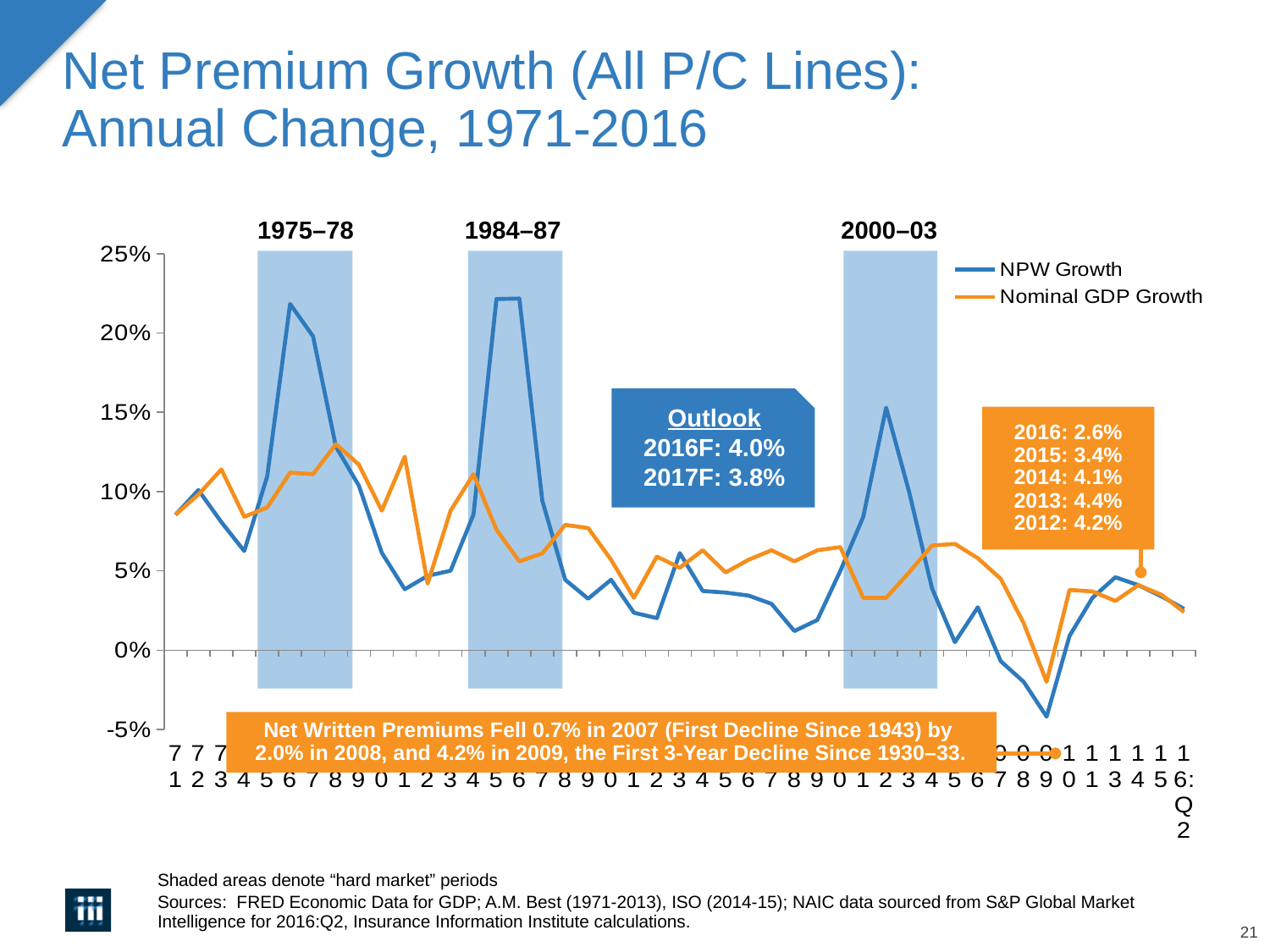
According to the callout, what was net premium growth in 2016? 2.6% What is the difference between the 2013 value (4.4%) and the 2012 value (4.2%) in the callout? 0.2 percentage points By how much did net written premiums fall in 2009, according to the text box? 4.2% What are the two series named in the legend? NPW Growth and Nominal GDP Growth In 2002, which series has the larger value, NPW Growth or Nominal GDP Growth? NPW Growth What type of chart is shown on the slide? Line chart According to the callout, what was net premium growth in 2013? 4.4% How many shaded 'hard market' periods are marked on the chart? 3 What is the 2017F outlook value for net premium growth? 3.8% How many series does the legend list? 2 Which year shows the lowest NPW Growth value on the chart? 2009 Is the NPW Growth value for 2002 greater or less than 10%? greater